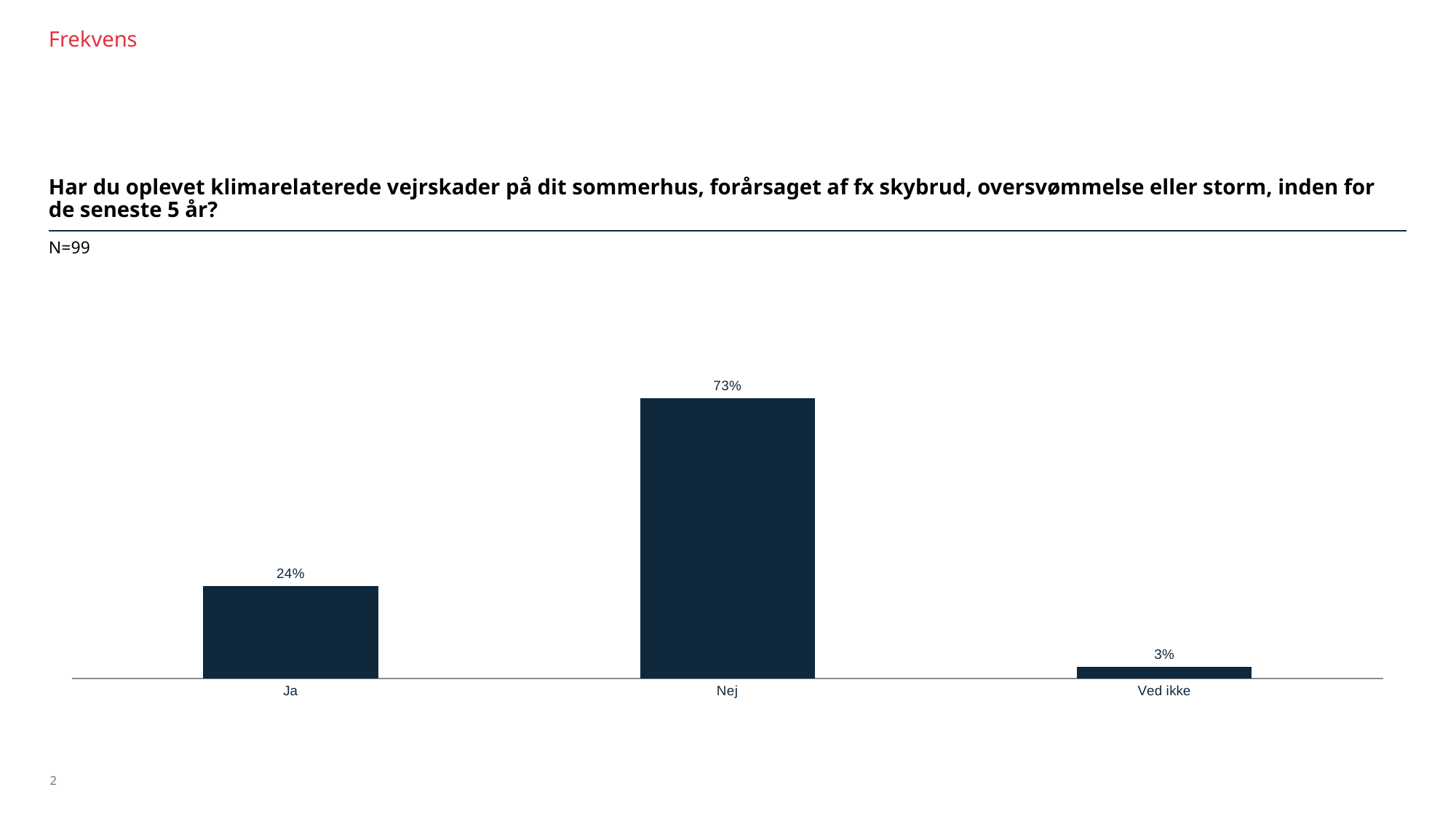
What is the value for Nej? 73% What is the value for Ja? 24% How many categories are shown on the x axis? 3 Which category has the highest value? Nej What is the difference between the values for Ja and Ved ikke? 21% What is the difference between the values for Nej and Ja? 49% What is the sample size (N) stated on the slide? N=99 What is the total of the values for Ja, Nej and Ved ikke? 100% What kind of chart is shown on the slide? bar chart Which is larger, the value for Ja or the value for Ved ikke? Ja What is the value for Ved ikke? 3% Which category has the lowest value? Ved ikke